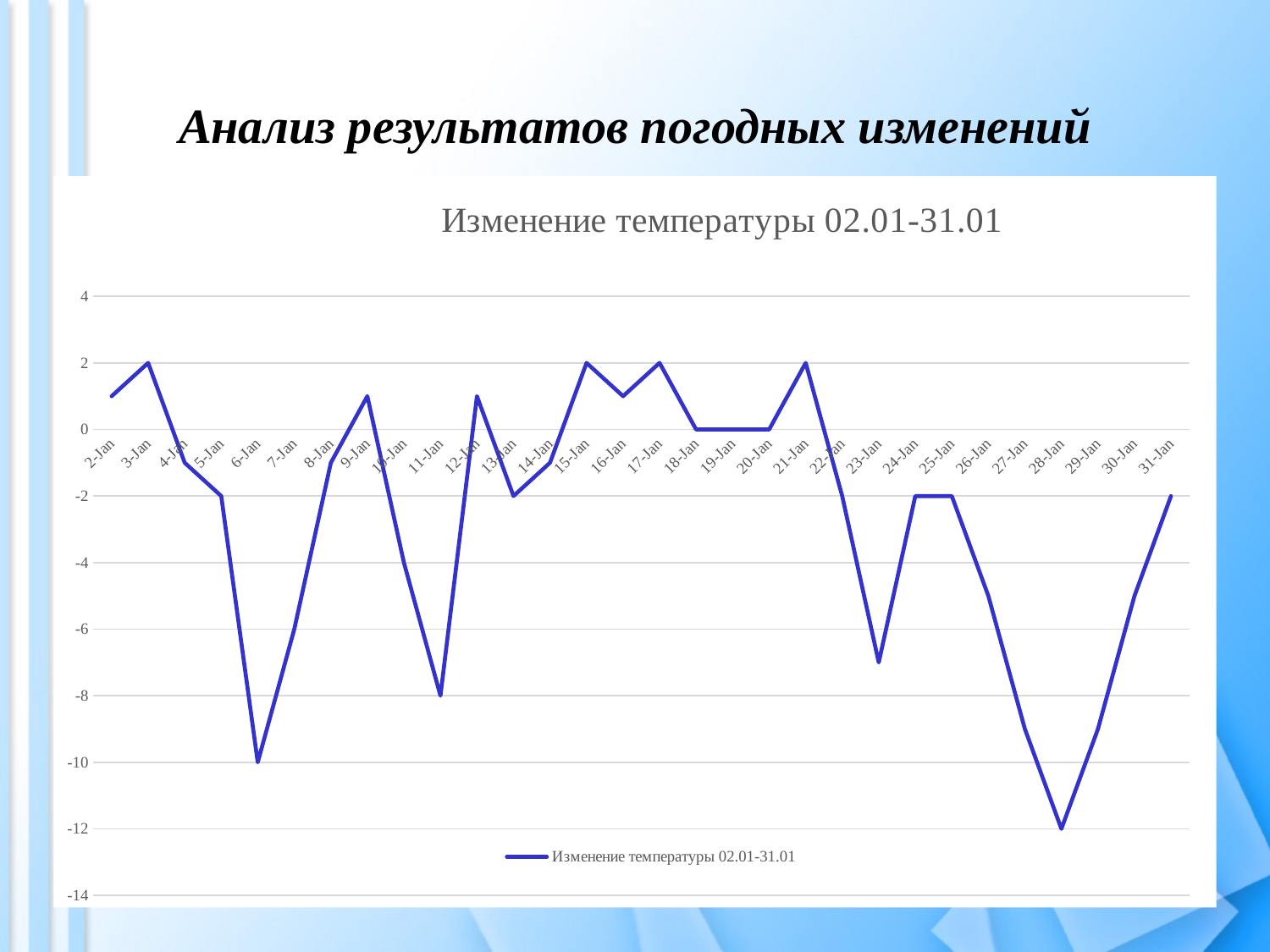
On which date is the temperature change lowest? 28-Jan What is the value for 28-Jan? -12 Is the value for 23-Jan greater or less than -6? less What kind of chart is shown on the slide? line chart Do the values rise or fall from 28-Jan to 31-Jan? rise Which is larger, the value for 6-Jan or the value for 11-Jan? 11-Jan What is the difference between the value for 6-Jan and the value for 28-Jan? 2 How many series does the legend list? 1 What is the title of the chart? Изменение температуры 02.01-31.01 What is the value for 11-Jan? -8 What is the value for 6-Jan? -10 How many dates are plotted along the x axis? 30